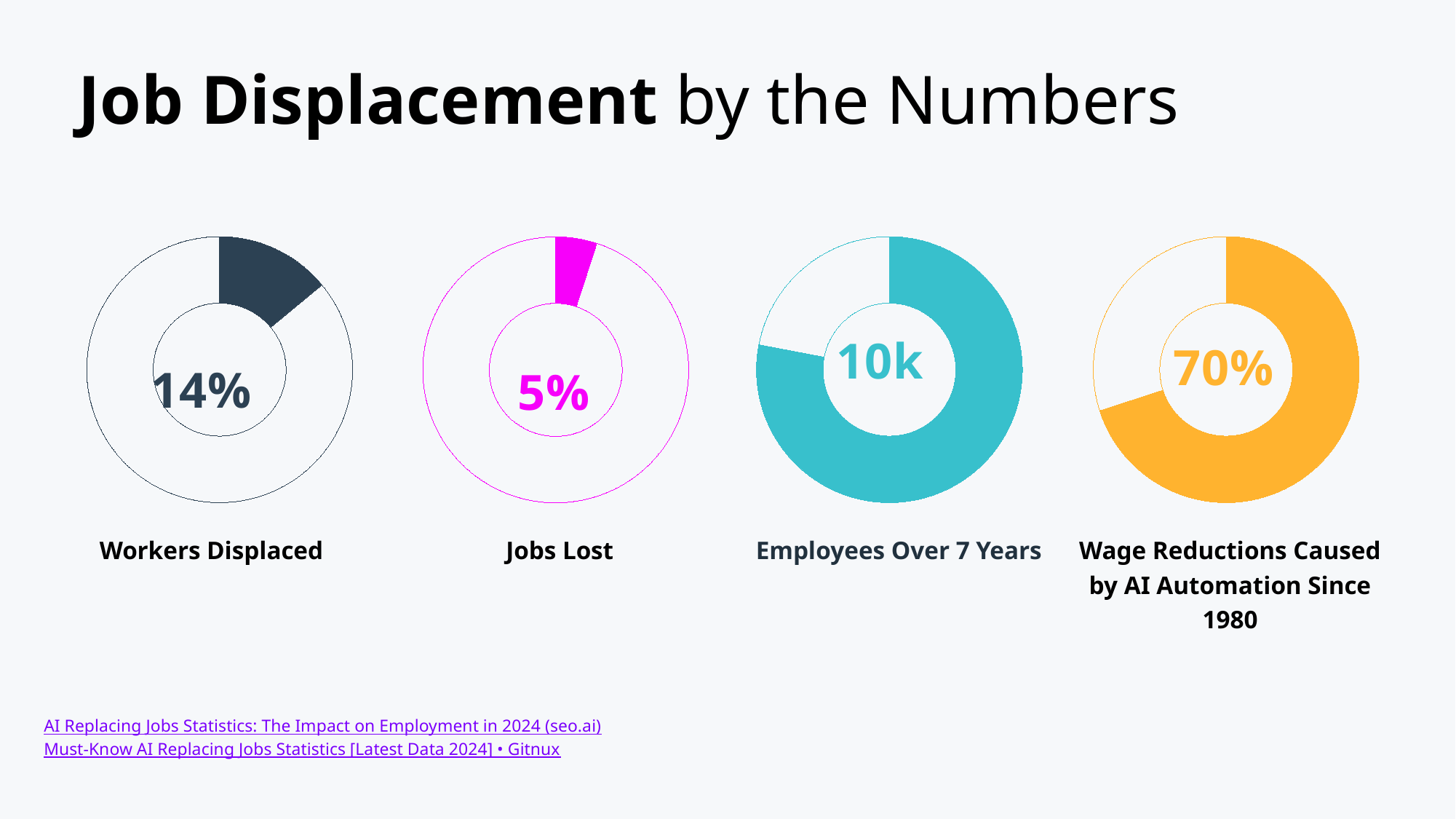
Which is larger, the "Workers Displaced" value or the "Jobs Lost" value? Workers Displaced How many donut charts are shown on the slide? 4 Which of the percentage donut charts shows the lowest value? Jobs Lost What value is shown in the centre of the "Workers Displaced" donut chart? 14% What is the difference between the "Wage Reductions Caused by AI Automation Since 1980" value and the "Workers Displaced" value? 56% What value is shown in the centre of the "Jobs Lost" donut chart? 5% What value is shown in the centre of the "Employees Over 7 Years" donut chart? 10k What kind of chart is used for each of the four figures on the slide? Donut chart What value is shown in the centre of the "Wage Reductions Caused by AI Automation Since 1980" donut chart? 70% What colour is the filled segment of the "Jobs Lost" donut chart? Magenta Which of the percentage donut charts shows the highest value? Wage Reductions Caused by AI Automation Since 1980 What is the difference between the "Workers Displaced" value and the "Jobs Lost" value? 9%